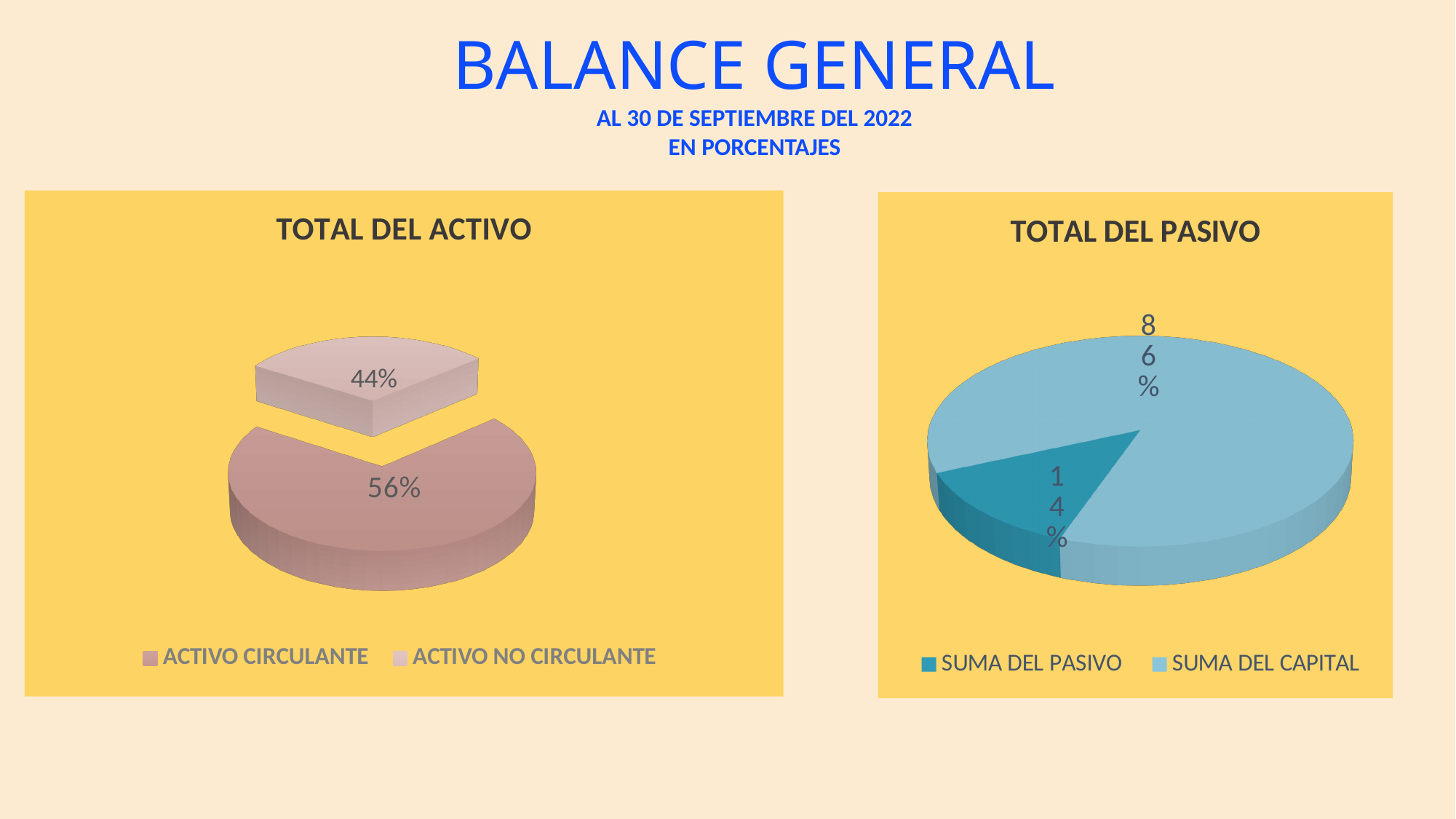
How many slices does the 'TOTAL DEL PASIVO' chart have? 2 In the 'TOTAL DEL ACTIVO' chart, what percentage is shown for ACTIVO CIRCULANTE? 56% What kind of chart is the 'TOTAL DEL ACTIVO' chart? Pie chart In the 'TOTAL DEL ACTIVO' chart, what is the difference in percentage points between ACTIVO CIRCULANTE and ACTIVO NO CIRCULANTE? 12 In the 'TOTAL DEL PASIVO' chart, which slice is the smallest? SUMA DEL PASIVO What are the legend entries of the 'TOTAL DEL ACTIVO' chart? ACTIVO CIRCULANTE, ACTIVO NO CIRCULANTE In the 'TOTAL DEL PASIVO' chart, what percentage is shown for SUMA DEL CAPITAL? 86% In the 'TOTAL DEL PASIVO' chart, what is the difference in percentage points between SUMA DEL CAPITAL and SUMA DEL PASIVO? 72 In the 'TOTAL DEL ACTIVO' chart, what percentage is shown for ACTIVO NO CIRCULANTE? 44% In the 'TOTAL DEL PASIVO' chart, which is larger, SUMA DEL PASIVO or SUMA DEL CAPITAL? SUMA DEL CAPITAL In the 'TOTAL DEL ACTIVO' chart, which slice is the largest? ACTIVO CIRCULANTE In the 'TOTAL DEL PASIVO' chart, what percentage is shown for SUMA DEL PASIVO? 14%